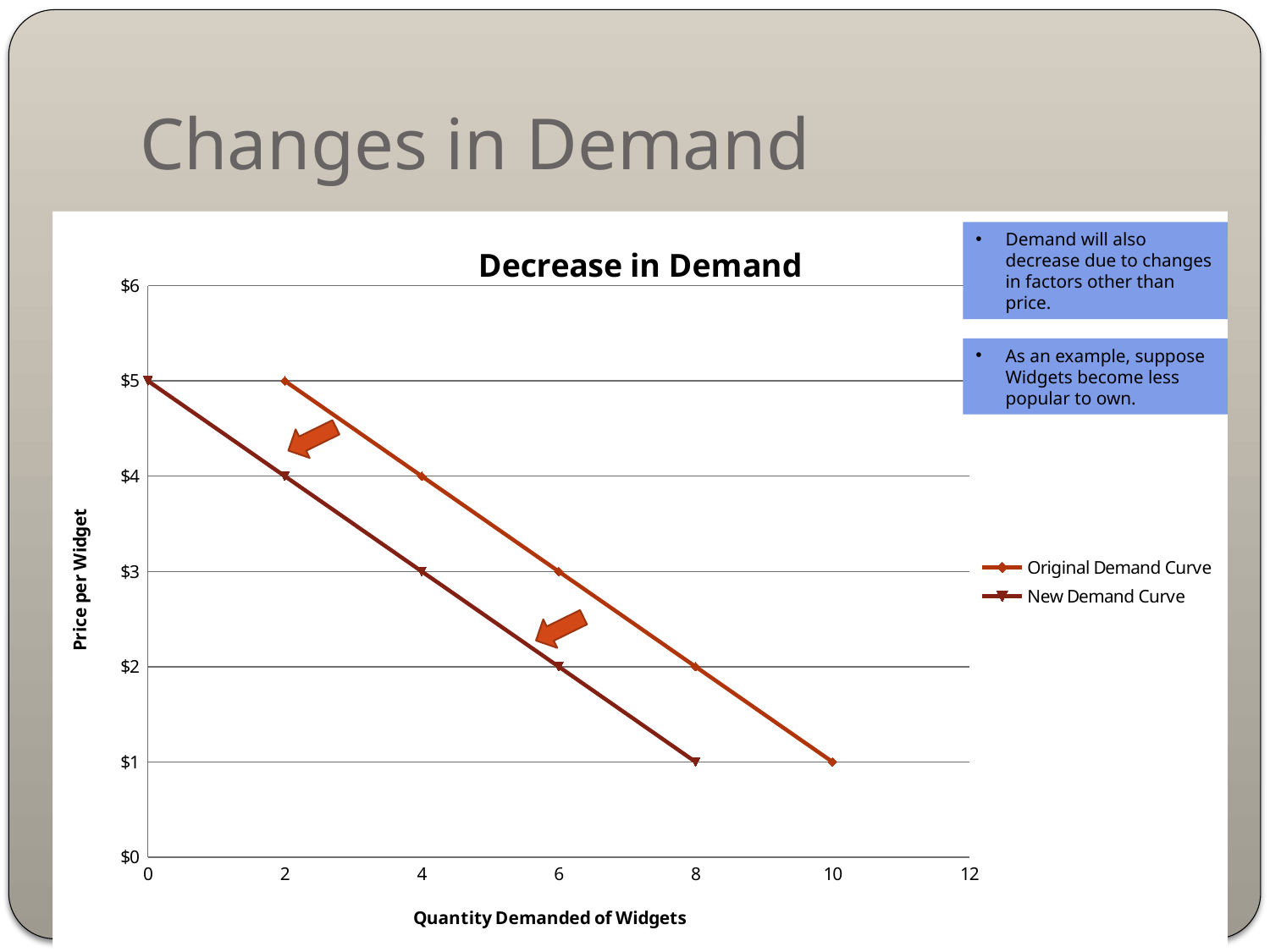
On the New Demand Curve, what is the price when the quantity demanded is 0? $5 How many series does the chart's legend list? 2 What is the title of the chart? Decrease in Demand At a price of $2, what is the difference in quantity demanded between the Original Demand Curve and the New Demand Curve? 2 As quantity demanded increases along the x axis, does the price on the Original Demand Curve rise or fall? fall On the New Demand Curve, what quantity is demanded at a price of $3? 4 How many data points are plotted on the Original Demand Curve? 5 On the Original Demand Curve, what quantity is demanded at a price of $3? 6 On the Original Demand Curve, what is the price when the quantity demanded is 10? $1 What is the label of the chart's y axis? Price per Widget What kind of chart is shown on the slide? line chart At a price of $4, which curve shows the larger quantity demanded, the Original Demand Curve or the New Demand Curve? Original Demand Curve